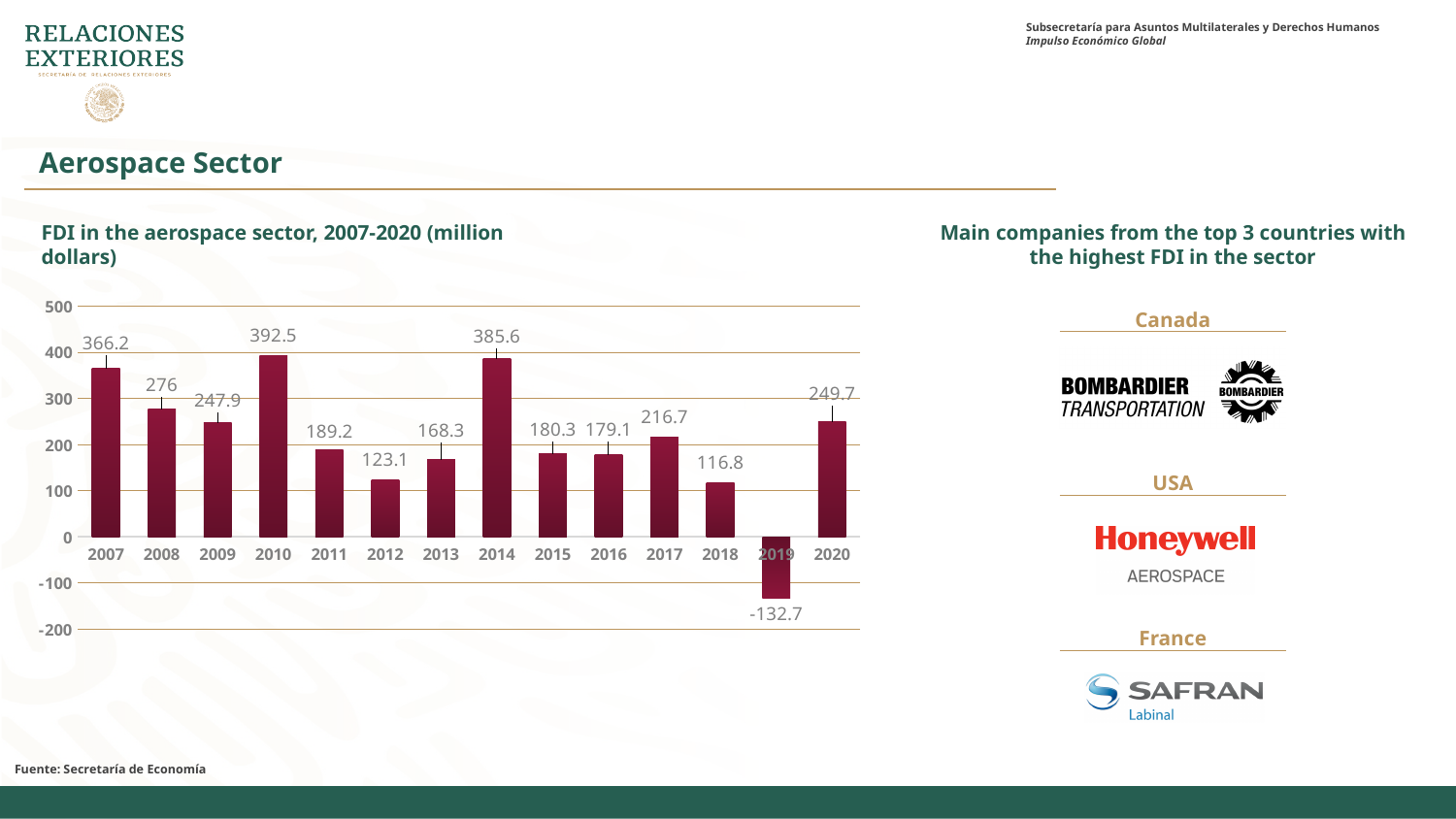
Which year has a larger FDI value, 2008 or 2017? 2008 What is the FDI value for 2010 in the aerospace sector chart? 392.5 How many years are shown in the FDI in the aerospace sector chart? 14 What is the title of the chart on the slide? FDI in the aerospace sector, 2007-2020 (million dollars) What is the source cited for the chart data? Secretaría de Economía What is the FDI value for 2019 in the aerospace sector chart? -132.7 What kind of chart is used to show FDI in the aerospace sector, 2007-2020? bar chart Which year has the highest FDI in the aerospace sector chart? 2010 Is the FDI value for 2012 greater or less than 200? less What is the difference between the FDI values for 2014 and 2013? 217.3 Which year has the lowest FDI in the aerospace sector chart? 2019 What is the FDI value for 2020 in the aerospace sector chart? 249.7